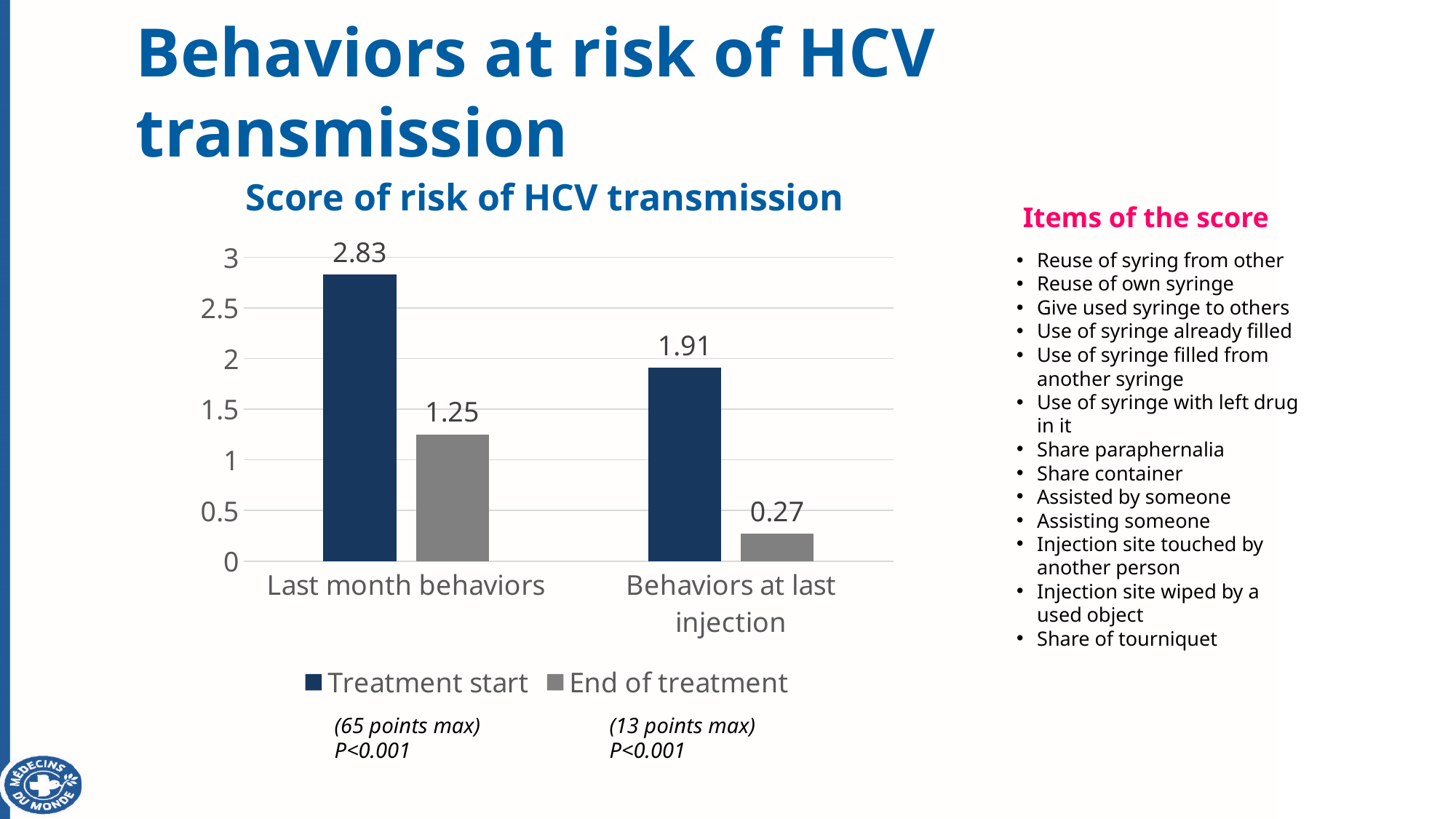
What is the Treatment start value for Last month behaviors? 2.83 Which bar has the highest value in the chart? Treatment start, Last month behaviors What is the title of the chart? Score of risk of HCV transmission What is the End of treatment value for Last month behaviors? 1.25 What is the Treatment start value for Behaviors at last injection? 1.91 What is the End of treatment value for Behaviors at last injection? 0.27 Which bar has the lowest value in the chart? End of treatment, Behaviors at last injection Which is larger: the End of treatment value for Last month behaviors or the Treatment start value for Behaviors at last injection? Treatment start value for Behaviors at last injection How many series does the legend list? 2 What is the difference between the Treatment start and End of treatment values for Behaviors at last injection? 1.64 What is the difference between the Treatment start and End of treatment values for Last month behaviors? 1.58 What kind of chart is shown on the slide? Bar chart